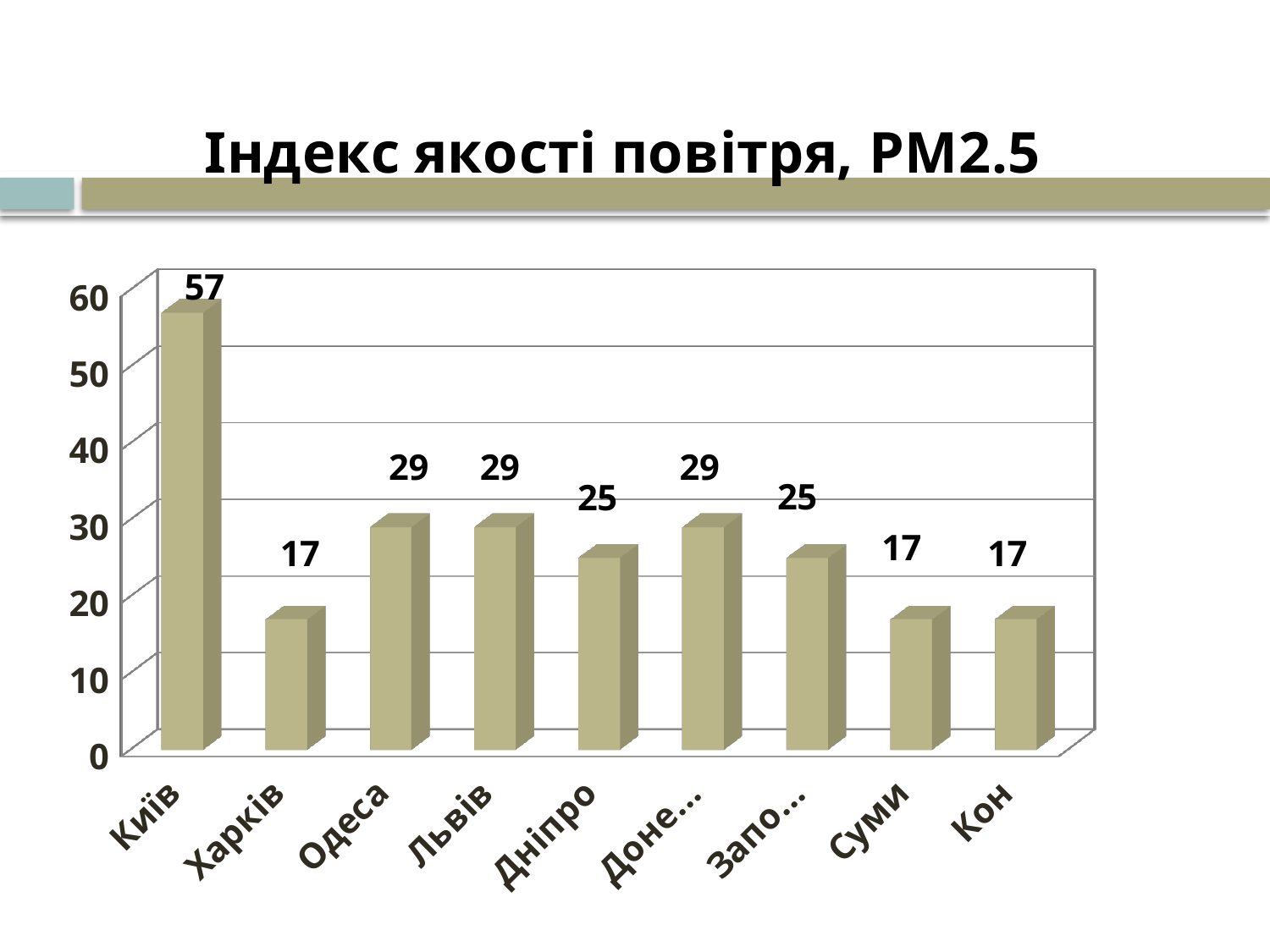
What is the value for Дніпро? 25 What is the title of the chart? Індекс якості повітря, PM2.5 What is the value for Одеса? 29 What is the difference between the values for Київ and Львів? 28 What is the value for Київ? 57 How many cities are shown on the chart? 9 What is the difference between the values for Одеса and Дніпро? 4 What kind of chart is shown on the slide? Bar chart What is the value for Харків? 17 Which city has the highest value? Київ Which is larger, the value for Львів or the value for Суми? Львів What is the value for Суми? 17